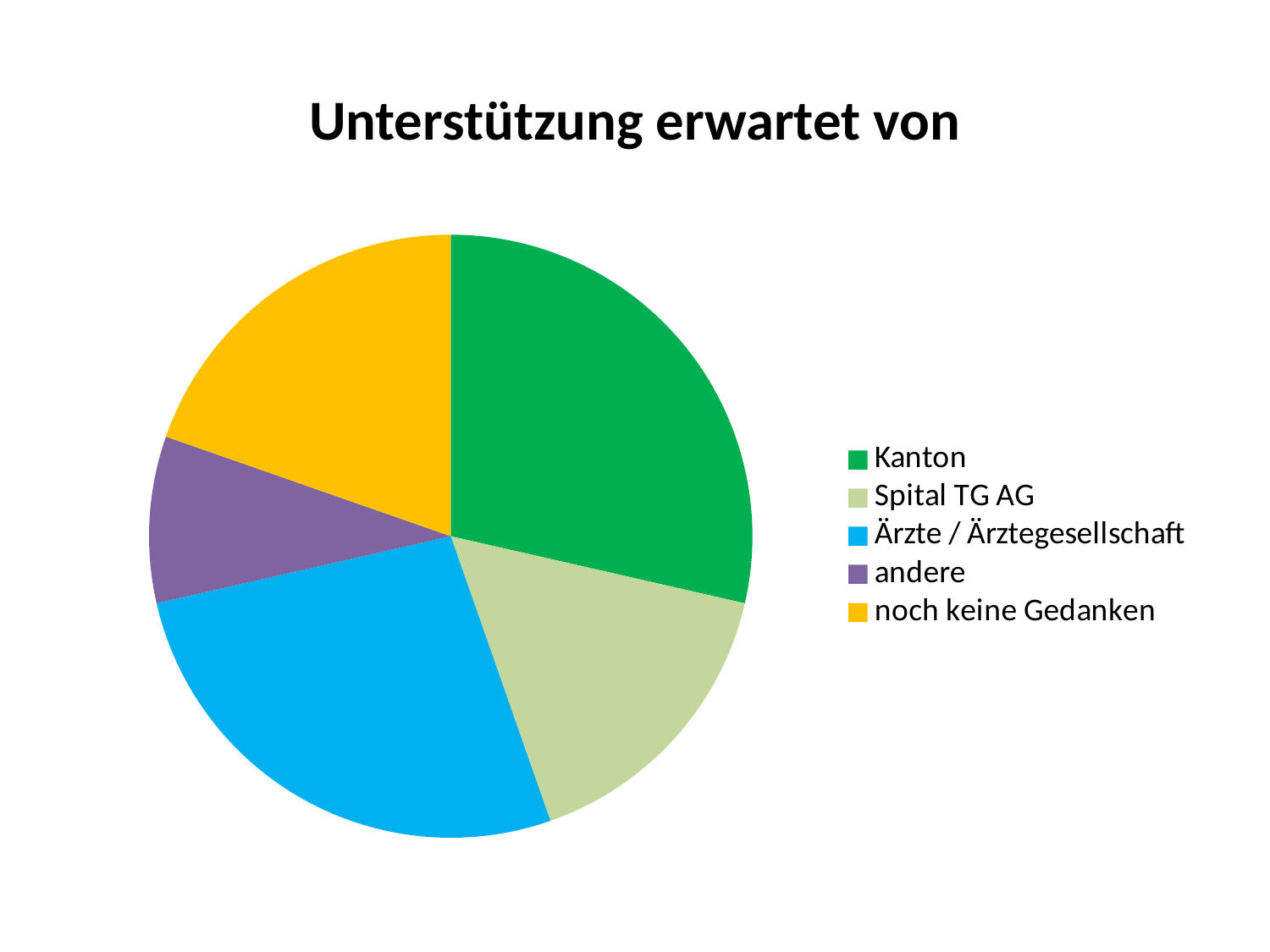
Which colour represents the category Kanton in the pie chart? green What kind of chart is shown on the slide? pie chart How many entries does the legend list? 5 Which slice is larger, Ärzte / Ärztegesellschaft or noch keine Gedanken? Ärzte / Ärztegesellschaft How many slices does the pie chart have? 5 Which category has the smallest slice of the pie? andere Which slice is larger, noch keine Gedanken or andere? noch keine Gedanken What is the title of the chart? Unterstützung erwartet von Which slice is larger, Ärzte / Ärztegesellschaft or andere? Ärzte / Ärztegesellschaft